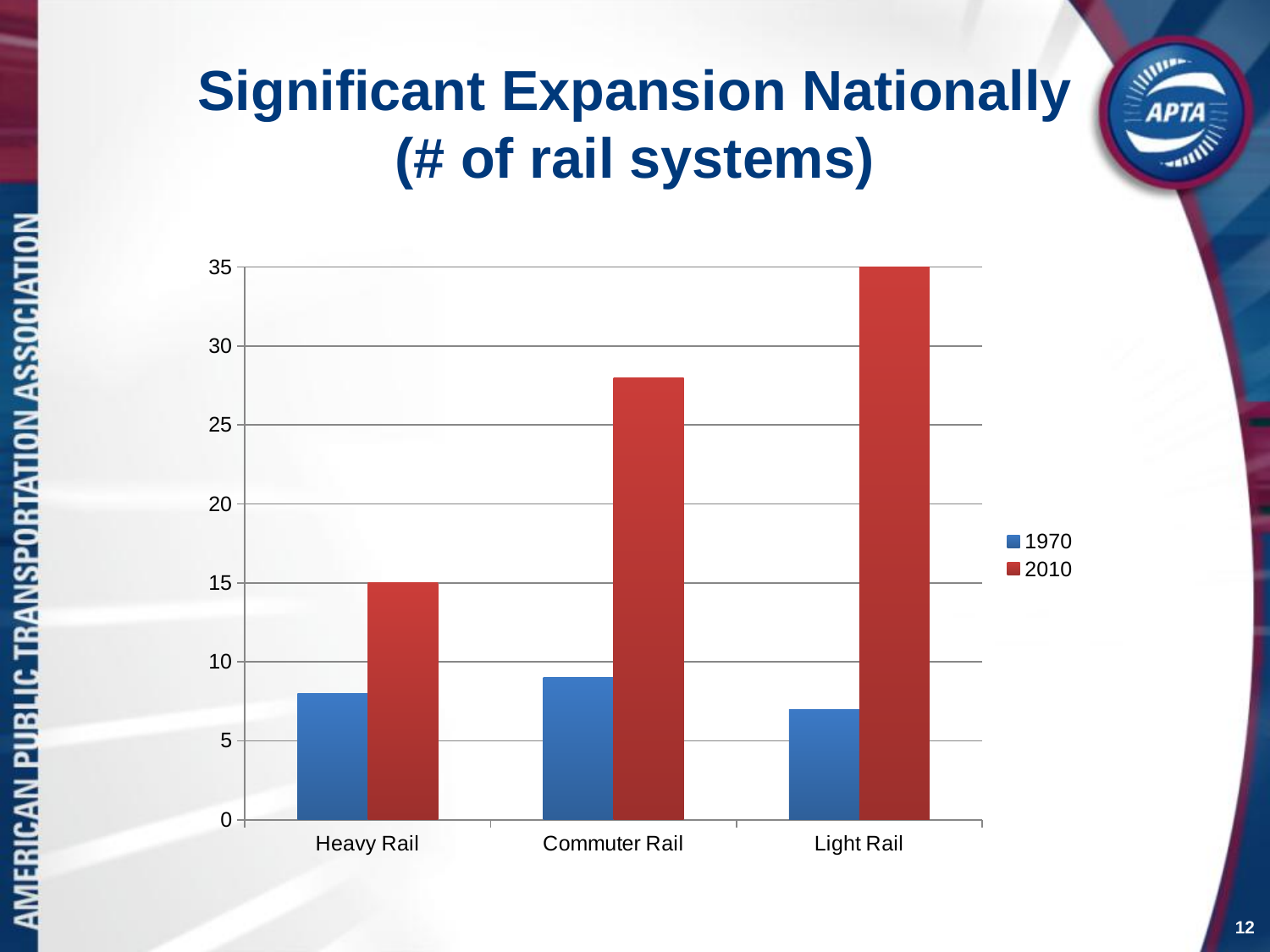
Which category has the lowest value for 2010? Heavy Rail Which is larger for Light Rail, the 1970 value or the 2010 value? 2010 Which category has the highest value for 2010? Light Rail Which colour represents the 2010 series in the legend? red What is the difference between the 2010 values for Light Rail and Heavy Rail? 20 What kind of chart is shown on the slide? bar chart What is the value for Heavy Rail in 2010? 15 Is the value for Commuter Rail in 2010 greater or less than 25? greater How many series does the legend list? 2 What is the value for Light Rail in 2010? 35 How many rail categories are shown on the x axis? 3 Is the value for Heavy Rail in 1970 greater or less than 10? less